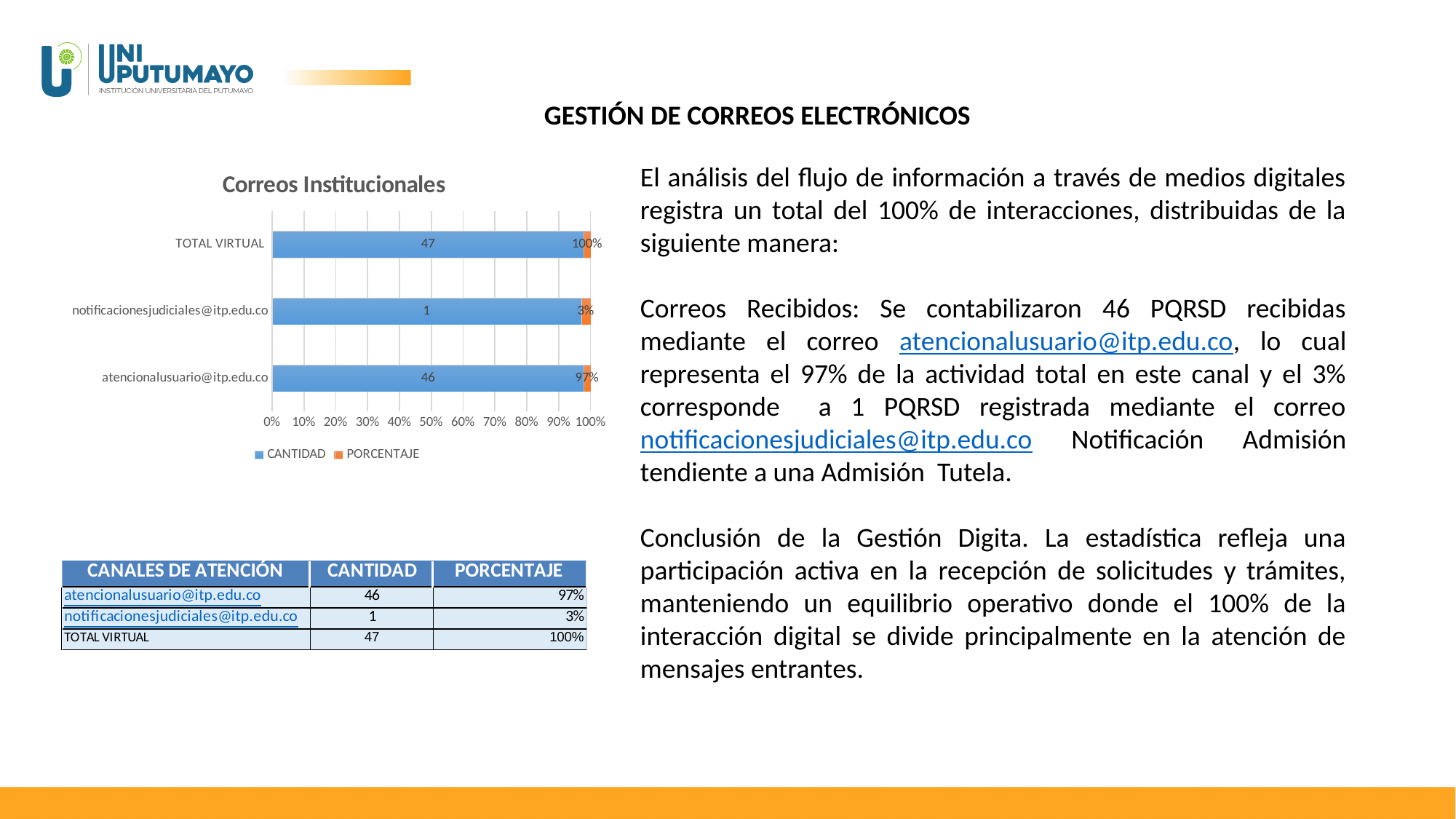
What is the difference in CANTIDAD between atencionalusuario@itp.edu.co and notificacionesjudiciales@itp.edu.co? 45 What is the CANTIDAD value for TOTAL VIRTUAL? 47 How many categories are shown on the chart? 3 Which has a larger PORCENTAJE value, atencionalusuario@itp.edu.co or notificacionesjudiciales@itp.edu.co? atencionalusuario@itp.edu.co Which series is shown in orange in the chart legend? PORCENTAJE Which category has the lowest CANTIDAD value? notificacionesjudiciales@itp.edu.co What is the PORCENTAJE value for notificacionesjudiciales@itp.edu.co? 3% What is the title of the chart? Correos Institucionales What kind of chart is shown on the slide? bar chart How many series does the chart legend list? 2 What is the PORCENTAJE value for atencionalusuario@itp.edu.co? 97% What is the CANTIDAD value for atencionalusuario@itp.edu.co? 46